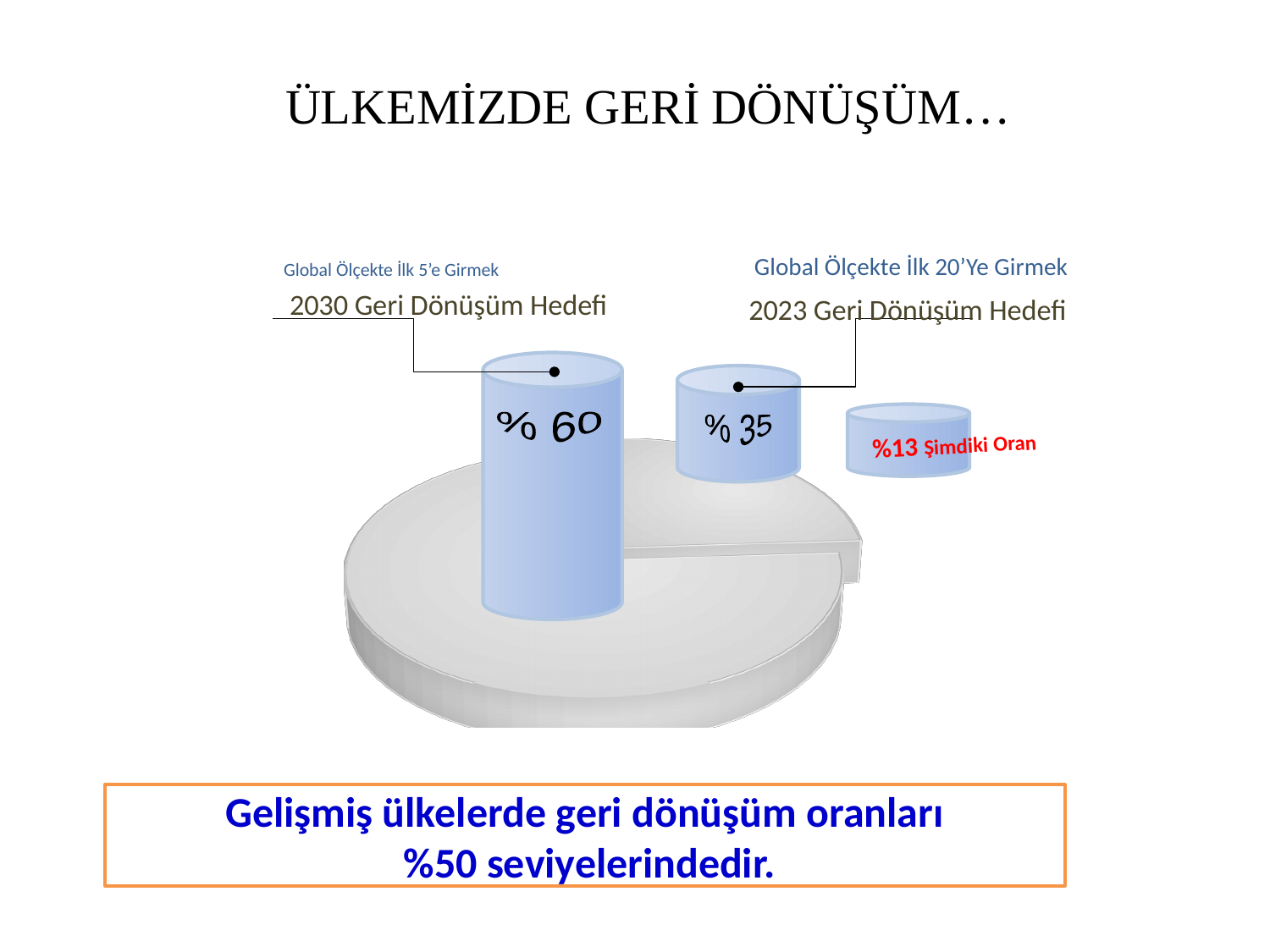
What kind of chart is shown on the slide? 3D pie chart What is the difference between the 2030 Geri Dönüşüm Hedefi and Şimdiki Oran? %47 Which category has the highest value? 2030 Geri Dönüşüm Hedefi Which category has the lowest value? Şimdiki Oran How many values (cylinders) are shown in the chart? 3 What is the value shown for the 2023 Geri Dönüşüm Hedefi? % 35 Do the values rise or fall from left to right across the cylinders? Fall Which is larger, the 2023 Geri Dönüşüm Hedefi or Şimdiki Oran? 2023 Geri Dönüşüm Hedefi What is the value shown for the 2030 Geri Dönüşüm Hedefi? % 60 What is the difference between the 2030 Geri Dönüşüm Hedefi and the 2023 Geri Dönüşüm Hedefi? %25 What is the value shown for Şimdiki Oran (the current rate)? %13 What is the title of the slide? ÜLKEMİZDE GERİ DÖNÜŞÜM…